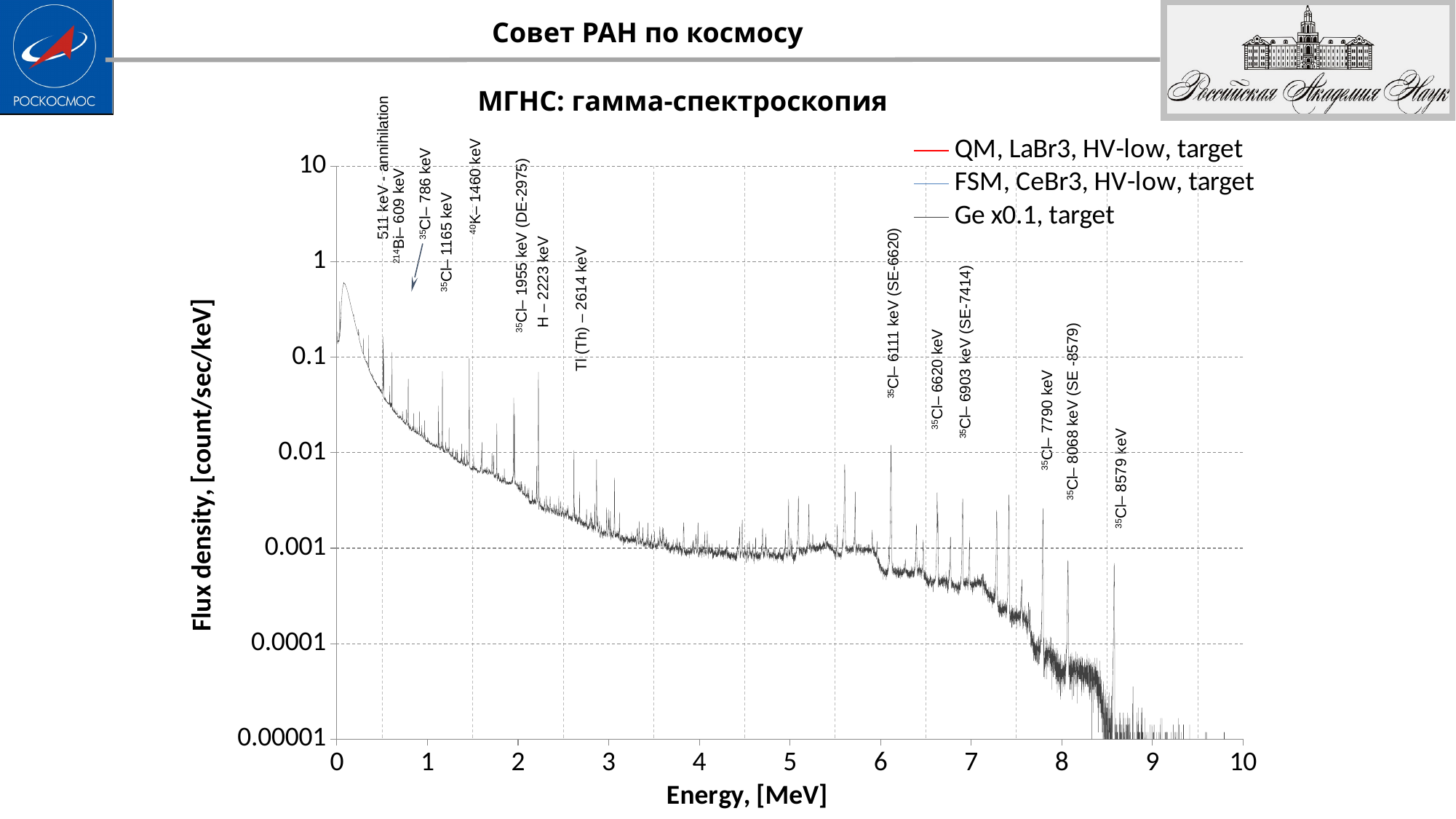
Is the flux density at 9 MeV greater or less than 0.0001? less Is the flux density at 4 MeV greater or less than 0.01? less What is the label of the x axis? Energy, [MeV] Is the flux density at 7 MeV greater or less than 0.001? less How many series does the legend list? 3 What is the title of the chart? МГНС: гамма-спектроскопия Overall, do the flux density values rise or fall as energy increases along the x axis? fall What is the maximum energy value shown on the x axis? 10 Which of the two energies, 1 MeV or 6 MeV, has the larger flux density? 1 MeV What kind of chart is shown on the slide? line chart What is the highest tick value shown on the y axis? 10